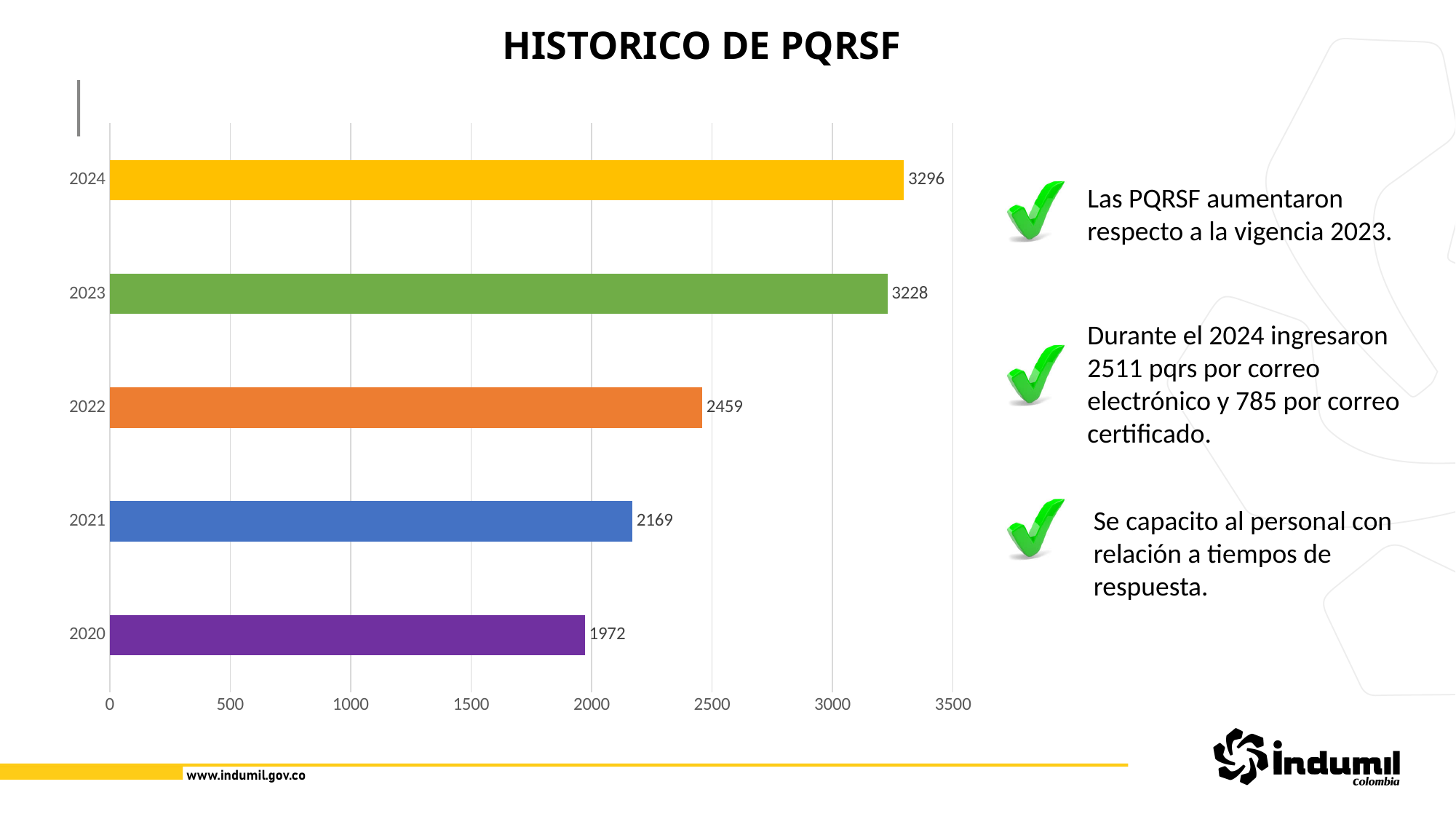
What is the value for 2020? 1972 What is the value for 2022? 2459 How many years are shown in the chart? 5 Which year has the highest value? 2024 Which year has the lowest value? 2020 What is the title of the chart? HISTORICO DE PQRSF What is the difference between the values for 2024 and 2023? 68 What is the value for 2024? 3296 What is the difference between the values for 2022 and 2021? 290 Which is larger, the value for 2021 or the value for 2022? 2022 Is the value for 2021 greater or less than 2000? greater What kind of chart is shown on the slide? bar chart